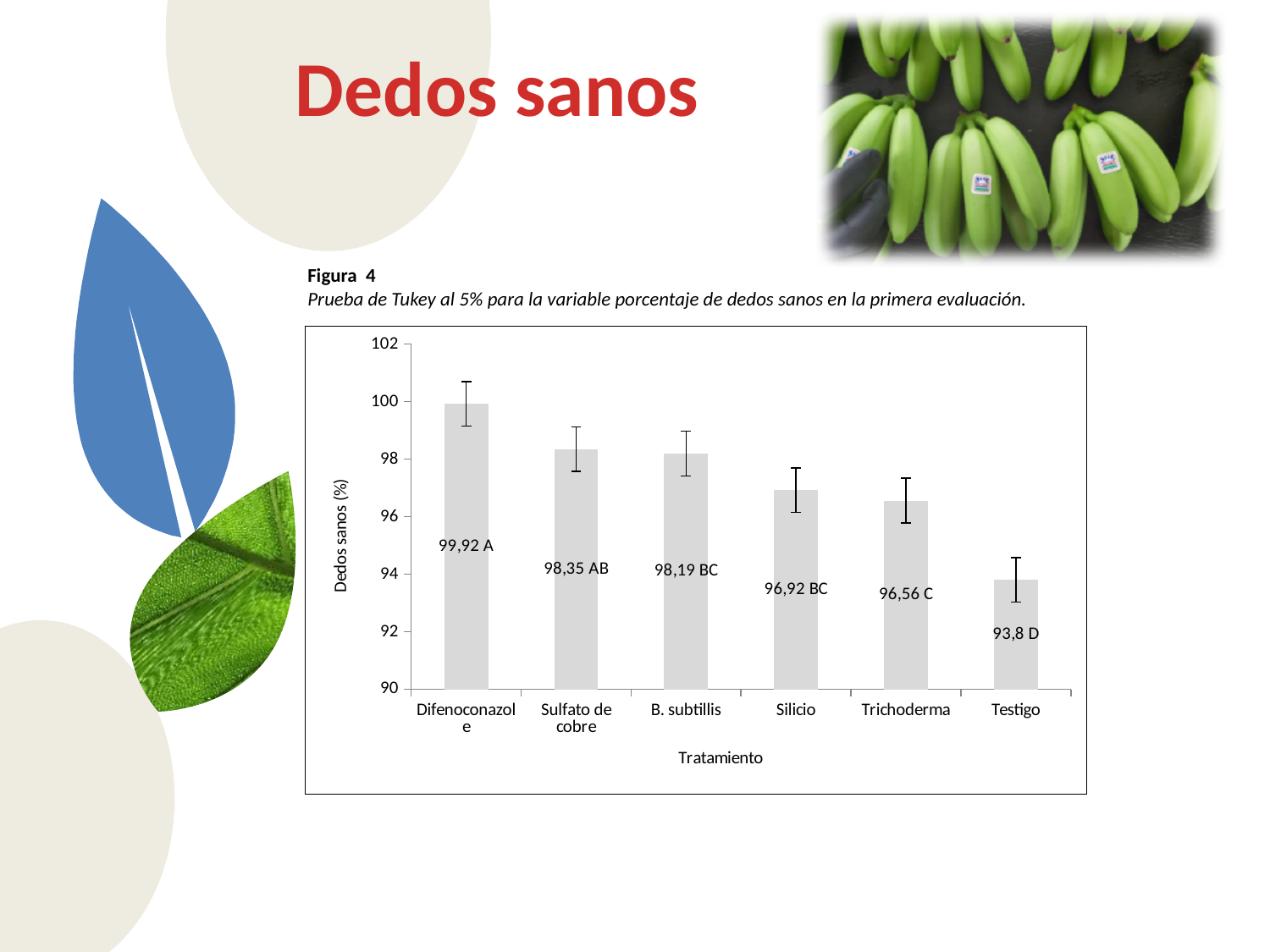
What is the data label shown for Silicio? 96,92 BC What is the label of the y axis? Dedos sanos (%) What is the data label shown for Trichoderma? 96,56 C Which treatment has the lowest percentage of healthy fingers (dedos sanos)? Testigo How many treatments are shown on the x axis? 6 Which has a larger value, Sulfato de cobre or Trichoderma? Sulfato de cobre What is the data label shown for Testigo? 93,8 D What kind of chart is shown on the slide? bar chart Is the value for Testigo greater or less than 94? less Which treatment has the highest percentage of healthy fingers (dedos sanos)? Difenoconazole What is the difference between the values for Difenoconazole and Testigo? 6,12 What is the data label shown for Difenoconazole? 99,92 A